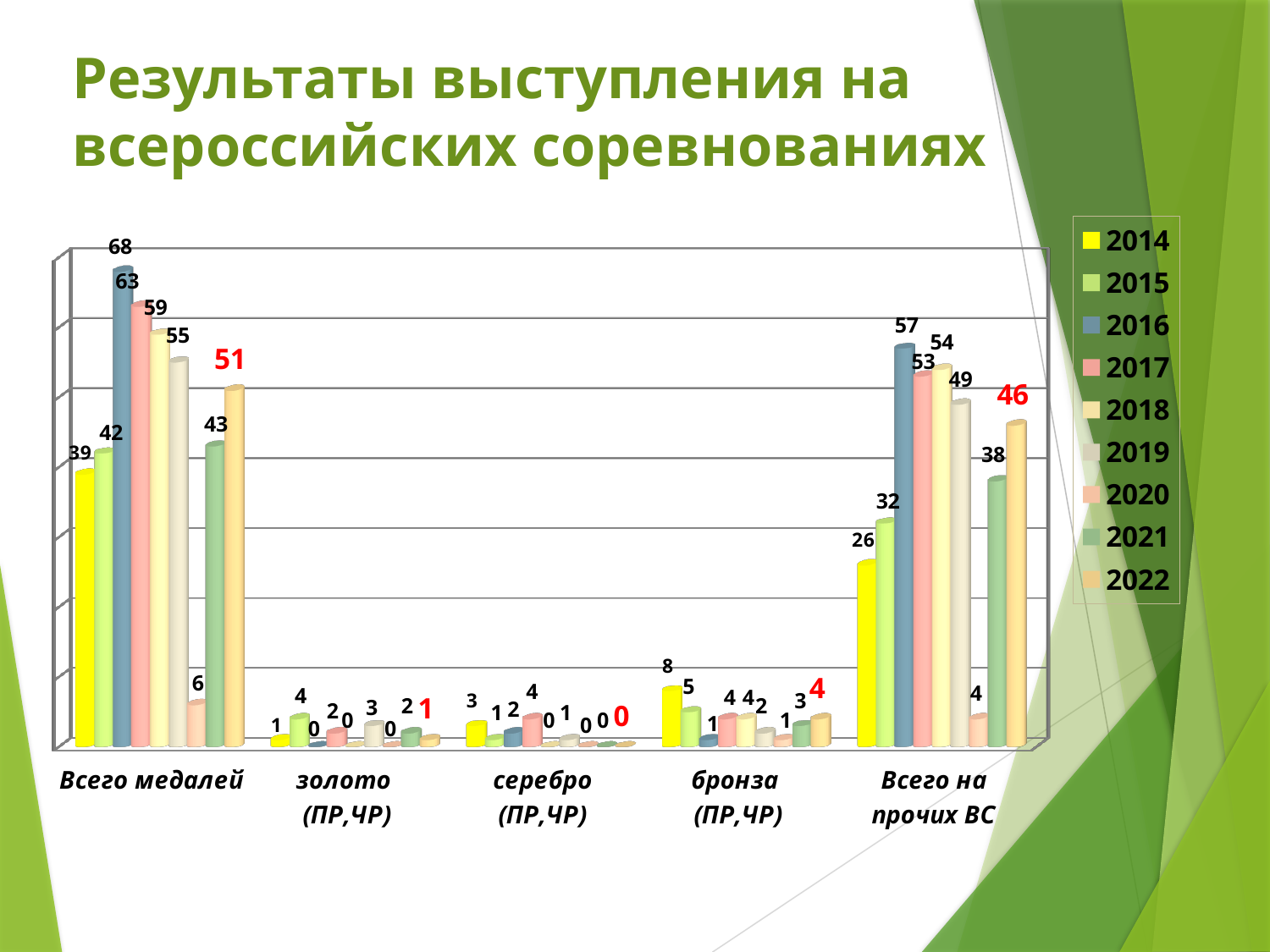
What is the value for 2014 in the 'бронза (ПР,ЧР)' category? 8 What is the value for 2022 in the 'Всего на прочих ВС' category? 46 Which year has the lowest value in the 'Всего медалей' category? 2020 In the 'Всего на прочих ВС' category, which is larger: the value for 2018 or the value for 2017? 2018 Which year has the highest value in the 'Всего медалей' category? 2016 What is the difference between the 2016 and 2014 values in the 'Всего на прочих ВС' category? 31 How many series does the legend list? 9 What is the value for 2016 in the 'Всего медалей' category? 68 What kind of chart is shown on the slide? Bar chart What is the difference between the 2016 and 2022 values in the 'Всего медалей' category? 17 How many categories are shown on the x axis of the chart? 5 What is the value for 2015 in the 'золото (ПР,ЧР)' category? 4